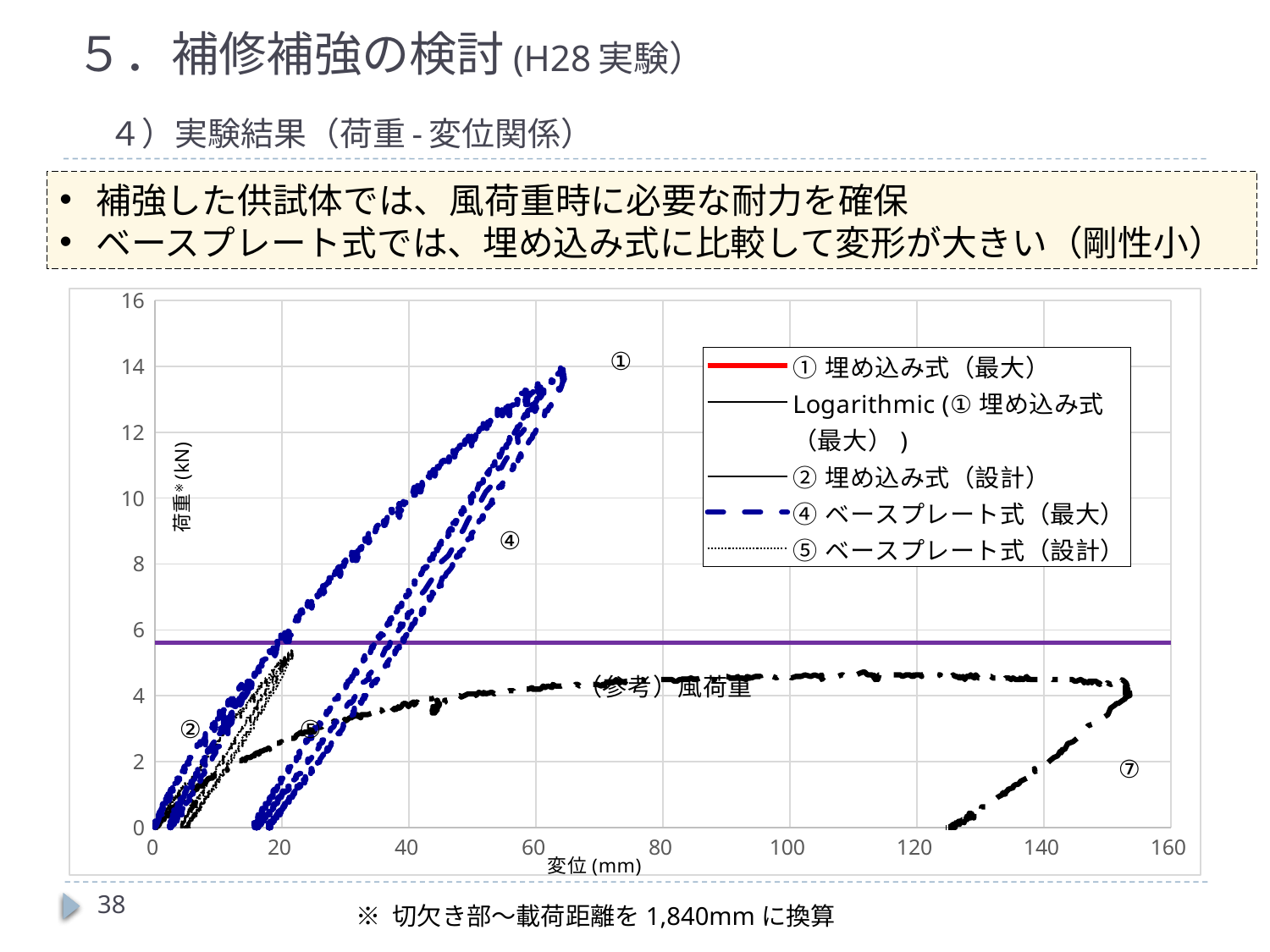
What is the label of the y axis of the chart? 荷重※ (kN) Is the maximum displacement reached by curve ⑦ greater or less than 140 mm? greater Which curve reaches the larger displacement, ④ or ⑦? ⑦ Which curve reaches the higher load, ① or ⑦? ① Is the horizontal reference line labelled （参考）風荷重 greater or less than 6 kN? less Is the peak load reached by curve ① greater or less than 12 kN? greater What is the highest value shown on the x axis of the chart? 160 How many series does the chart legend list? 5 What kind of chart is shown on the slide? scatter (line) chart What is the label of the x axis of the chart? 変位 (mm)